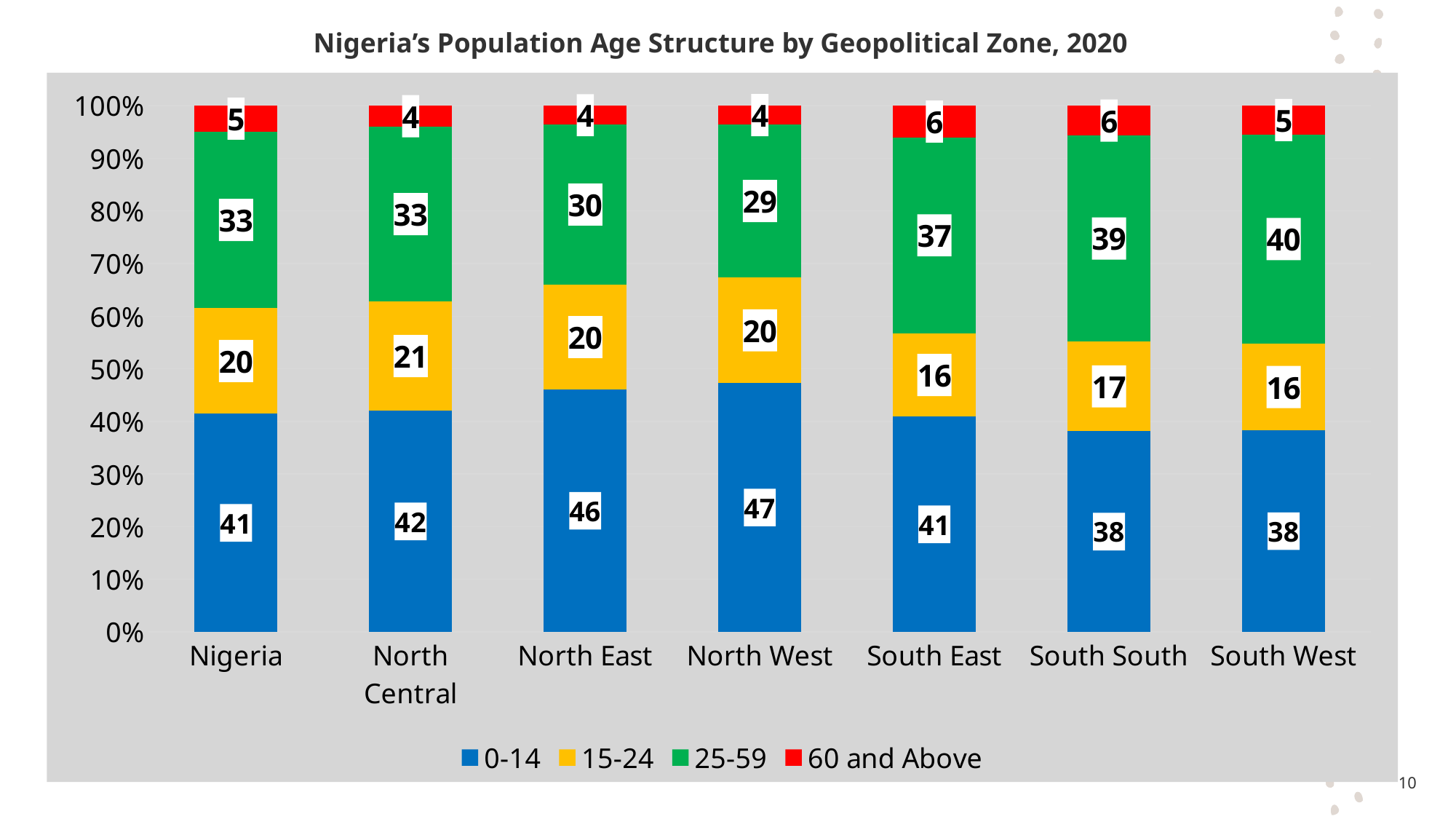
What kind of chart is shown on the slide? Stacked bar chart What is the title of the chart? Nigeria's Population Age Structure by Geopolitical Zone, 2020 What is the value for the 15-24 series for North Central? 21 How many series does the legend list? 4 How many categories are shown on the x axis? 7 Which zone has the lowest value for the 25-59 series? North West What is the value for the 25-59 series for South West? 40 Which is larger, the 25-59 value for South South or for North East? South South What is the value for the 0-14 series for North West? 47 What is the value for the 60 and Above series for South East? 6 What is the difference between the 0-14 values for North West and South West? 9 Which zone has the highest value for the 0-14 series? North West